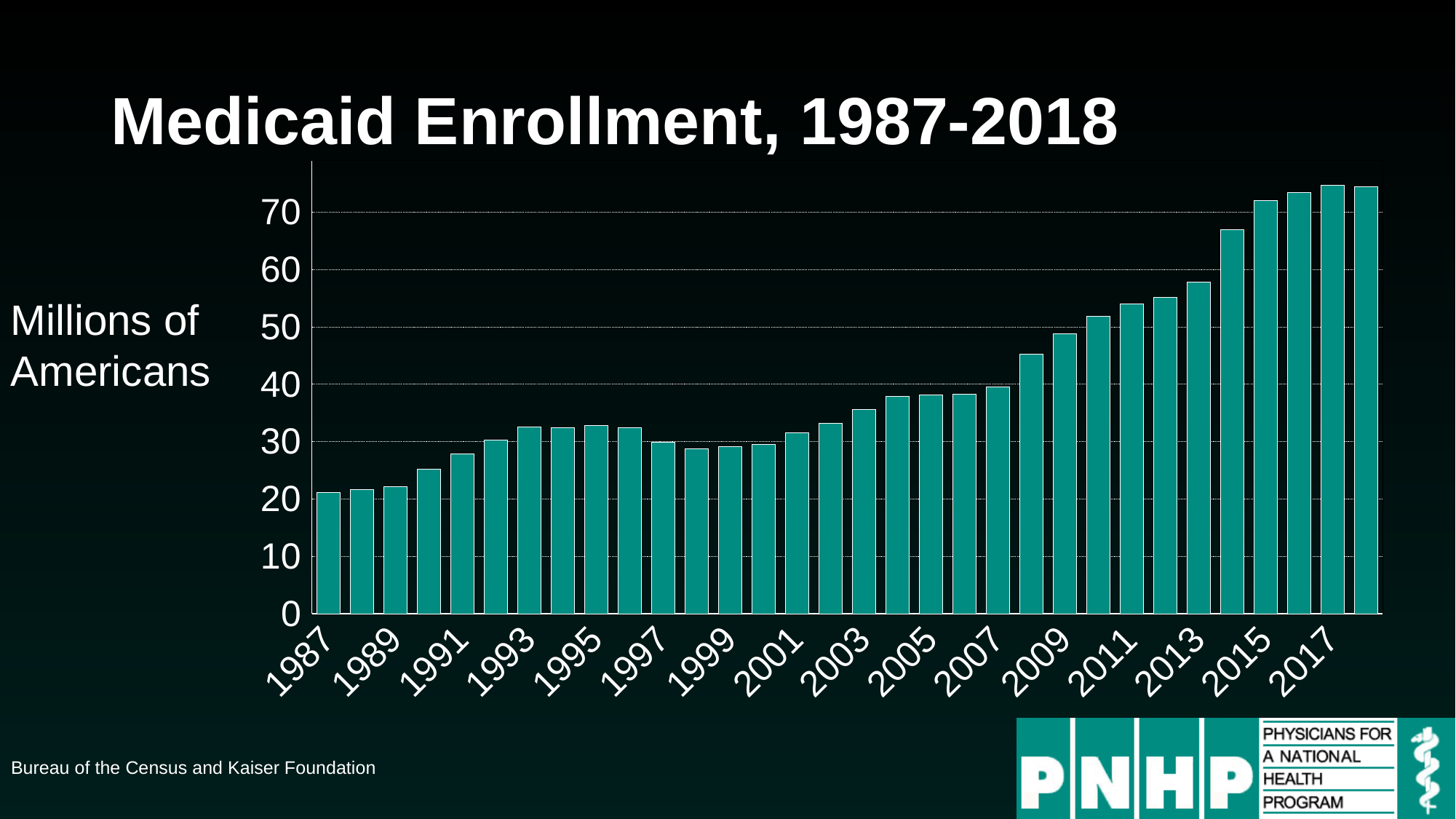
Is the value for 2013 greater or less than 50? greater Is the value for 2017 greater or less than 70? greater Which year has the larger value, 1999 or 2009? 2009 What kind of chart is shown on the slide? Bar chart What unit does the vertical axis represent, according to the label beside the chart? Millions of Americans Overall, do the values rise or fall from 1987 to 2018? Rise What is the title of the chart? Medicaid Enrollment, 1987-2018 How many bars (years) are plotted in the chart? 32 Is the value for 2005 greater or less than 40? less Which year has the larger value, 2005 or 2015? 2015